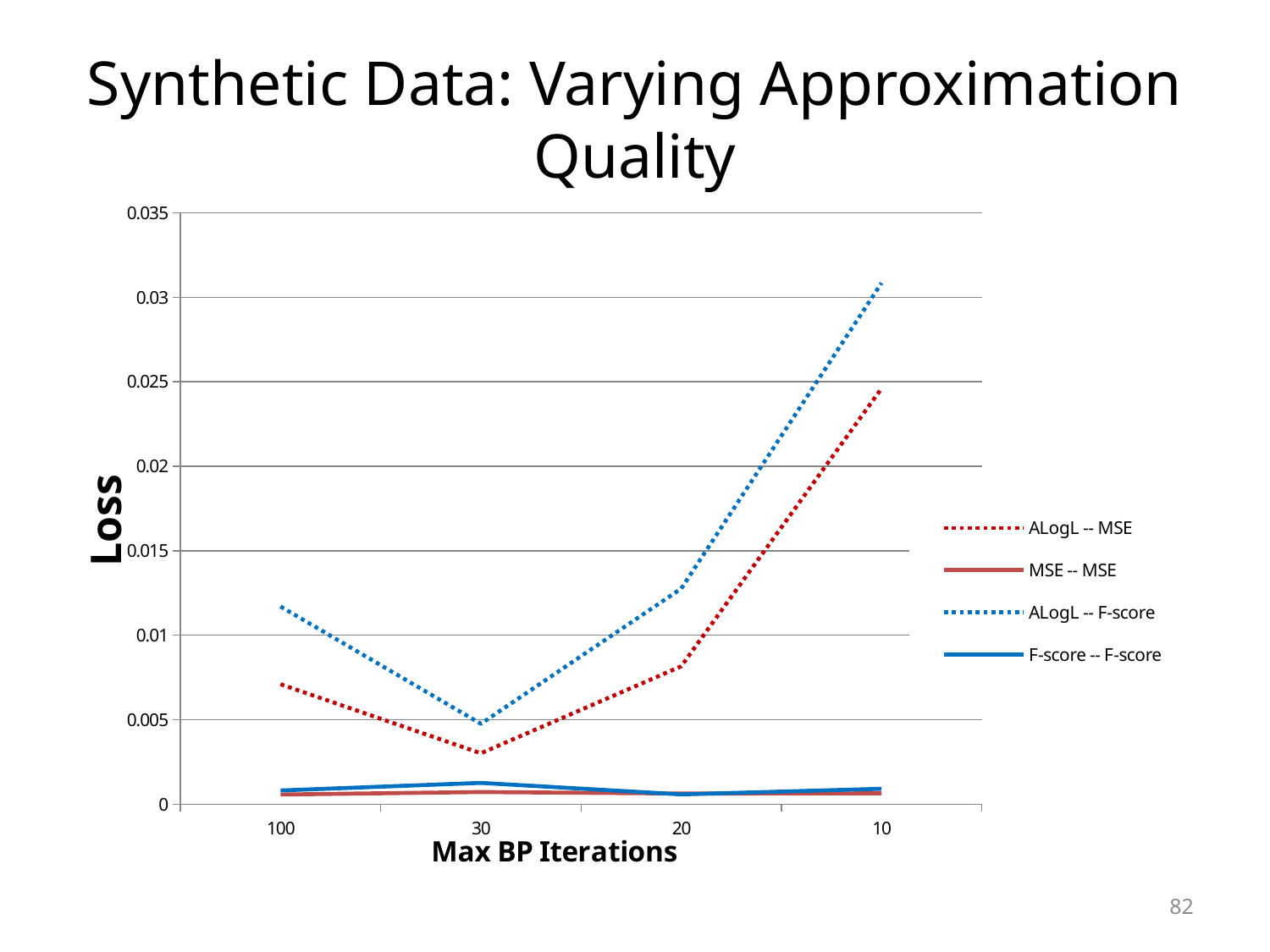
Is the ALogL -- F-score loss at Max BP Iterations = 100 greater or less than 0.01? greater At Max BP Iterations = 10, which series has the larger loss: ALogL -- F-score or ALogL -- MSE? ALogL -- F-score At which Max BP Iterations value is the ALogL -- F-score loss highest? 10 How many series does the legend list? 4 How many Max BP Iterations values are plotted along the x axis? 4 What kind of chart is shown on the slide? line chart Does the ALogL -- MSE loss rise or fall between Max BP Iterations = 20 and 10? rise What is the label of the y axis? Loss At which Max BP Iterations value is the ALogL -- MSE loss highest? 10 Is the ALogL -- MSE loss at Max BP Iterations = 30 greater or less than 0.005? less At which Max BP Iterations value is the ALogL -- F-score loss lowest? 30 Is the ALogL -- F-score loss at Max BP Iterations = 10 greater or less than 0.025? greater